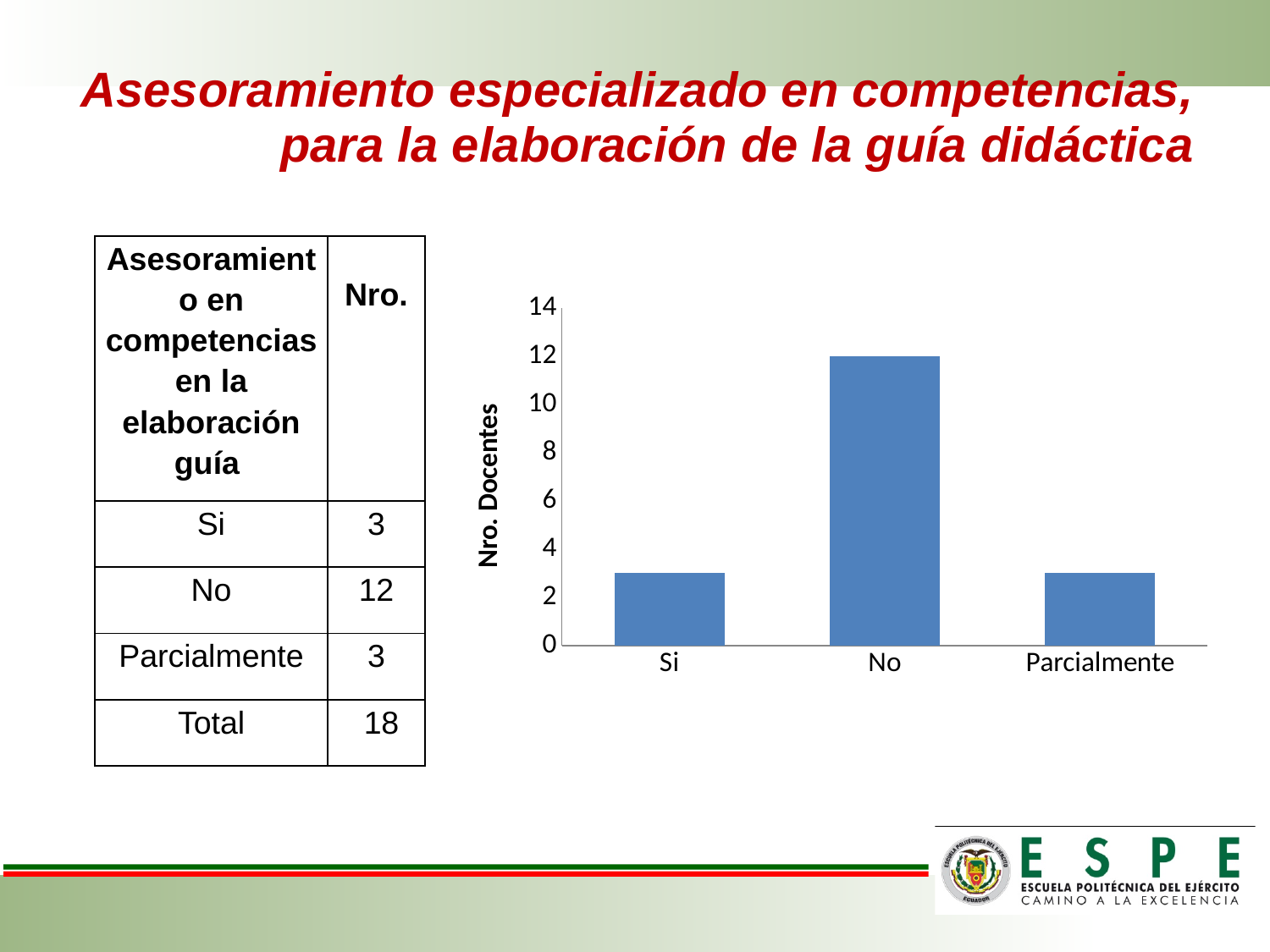
Is the value for Si greater or less than 4? less How many categories are shown on the x axis of the chart? 3 Which category has the highest value in the chart? No What is the value for Parcialmente according to the slide? 3 What is the value for Si according to the slide? 3 Is the value for No greater or less than 10? greater What is the difference between the value for No and the value for Si? 9 What is the value for No in the chart? 12 What is the total number of docentes shown in the table on the slide? 18 Which is larger, the value for No or the value for Parcialmente? No What is the label of the vertical axis of the chart? Nro. Docentes What type of chart is shown on the slide? bar chart